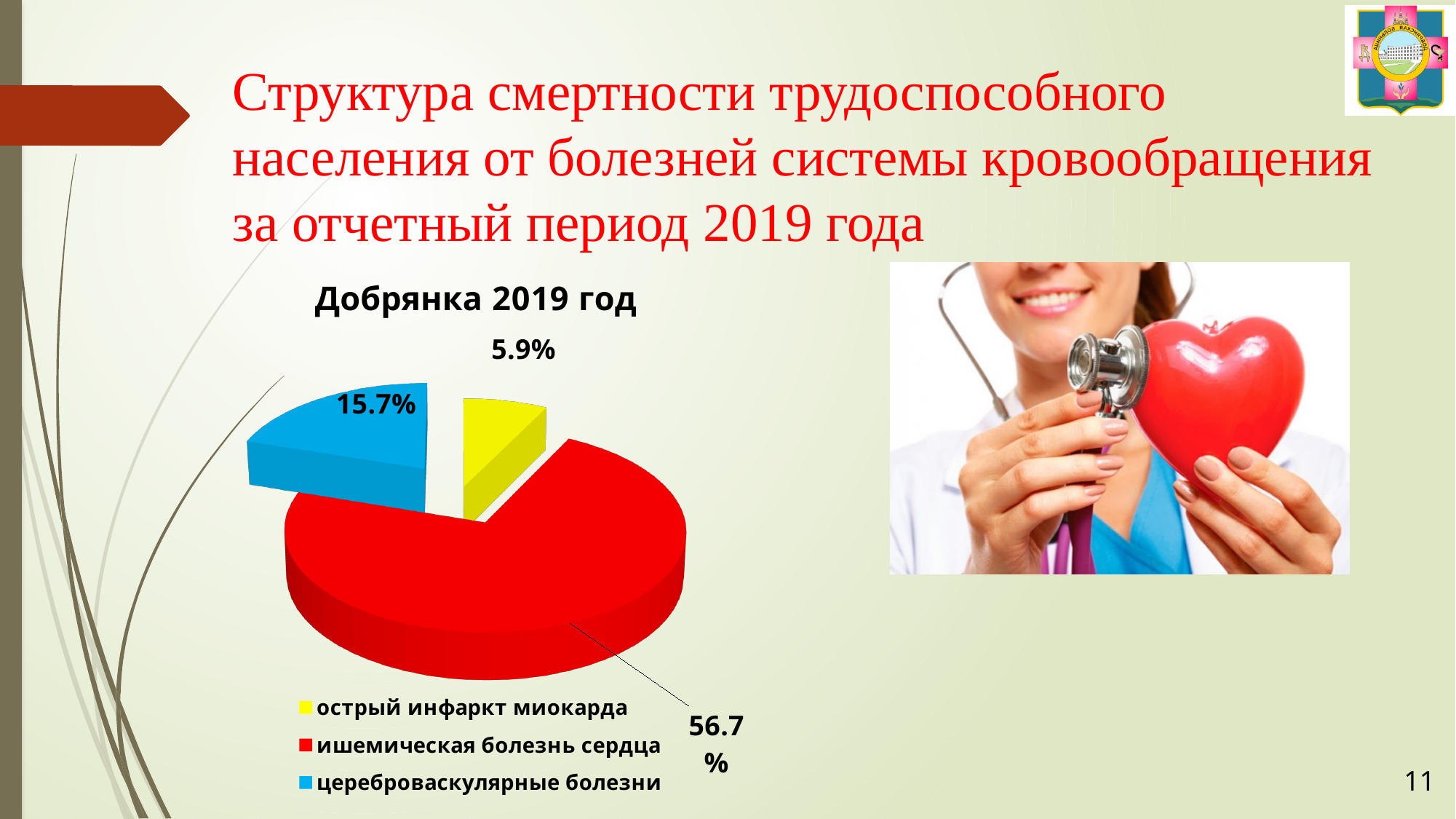
Which category has the smallest slice of the pie? острый инфаркт миокарда What is the title of the chart? Добрянка 2019 год How many categories does the pie chart show? 3 Which is larger, the slice for цереброваскулярные болезни or the slice for острый инфаркт миокарда? цереброваскулярные болезни What is the difference in percentage points between ишемическая болезнь сердца and цереброваскулярные болезни? 41 percentage points Which category has the largest slice of the pie? ишемическая болезнь сердца What is the difference in percentage points between цереброваскулярные болезни and острый инфаркт миокарда? 9.8 percentage points What percentage is shown for острый инфаркт миокарда? 5.9% What kind of chart is shown on the slide? pie chart What colour is the slice for ишемическая болезнь сердца? red What percentage is shown for ишемическая болезнь сердца? 56.7% What percentage is shown for цереброваскулярные болезни? 15.7%